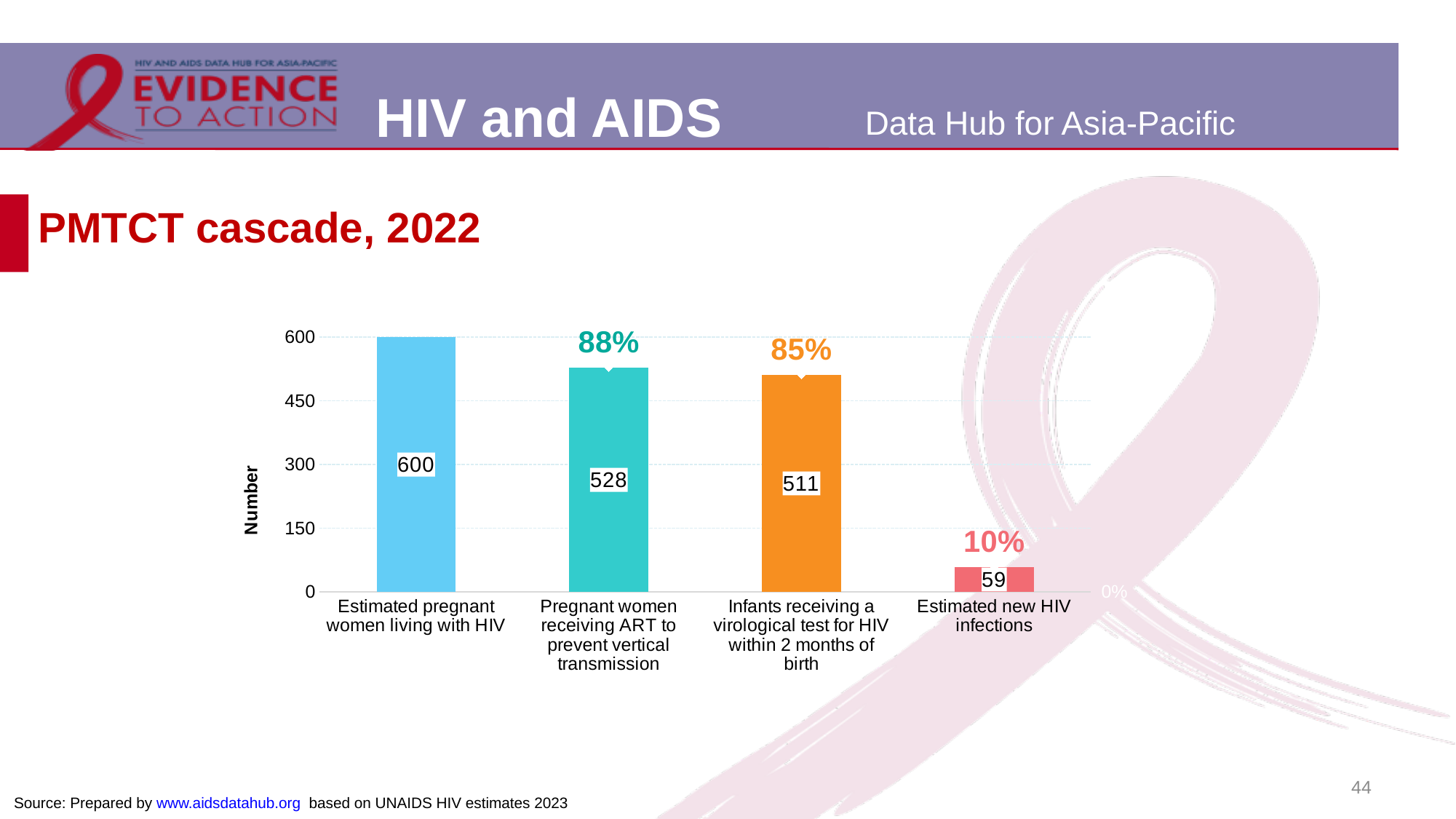
Which category has the lowest value? Estimated new HIV infections How many categories are shown on the x axis? 4 Which is larger: the value for Pregnant women receiving ART to prevent vertical transmission or the value for Infants receiving a virological test for HIV within 2 months of birth? Pregnant women receiving ART to prevent vertical transmission What is the value for Pregnant women receiving ART to prevent vertical transmission? 528 What kind of chart is shown on the slide? Bar chart What is the value for Infants receiving a virological test for HIV within 2 months of birth? 511 What is the value for Estimated new HIV infections? 59 What is the difference between the values for Estimated pregnant women living with HIV and Pregnant women receiving ART to prevent vertical transmission? 72 What percentage is shown above the bar for Estimated new HIV infections? 10% Which category has the highest value? Estimated pregnant women living with HIV What is the value for Estimated pregnant women living with HIV? 600 What percentage is shown above the bar for Pregnant women receiving ART to prevent vertical transmission? 88%